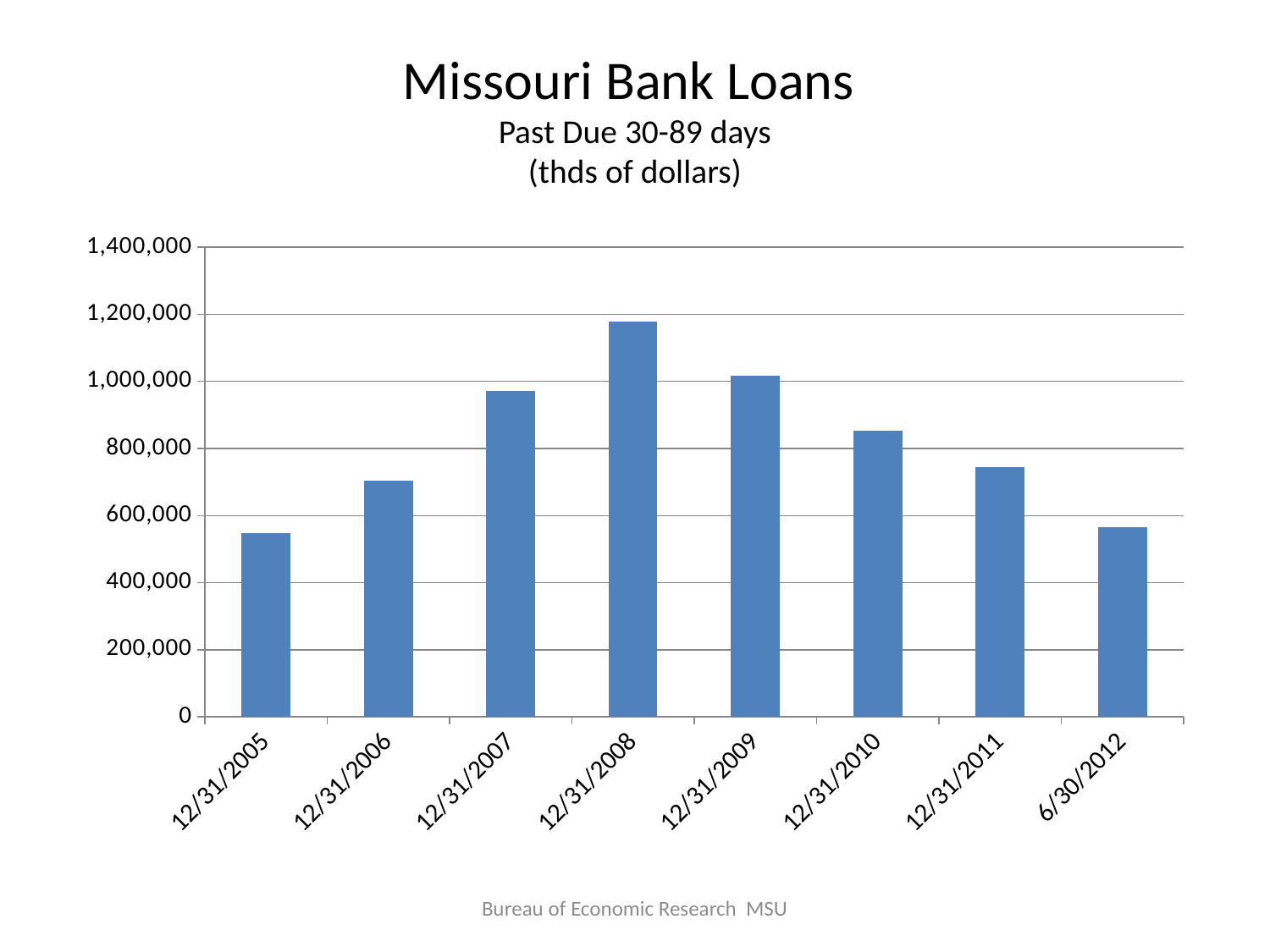
Is the value for 12/31/2010 greater or less than 800,000? greater Which date has the highest value of past due loans? 12/31/2008 Which is larger, the value for 12/31/2008 or the value for 12/31/2009? 12/31/2008 What kind of chart is shown on the slide? bar chart Do the values rise or fall from 12/31/2008 to 6/30/2012? fall Is the value for 6/30/2012 greater or less than 600,000? less Is the value for 12/31/2005 greater or less than 600,000? less In what units are the values on the chart expressed, according to the title? thds of dollars How many dates are shown on the x axis of the chart? 8